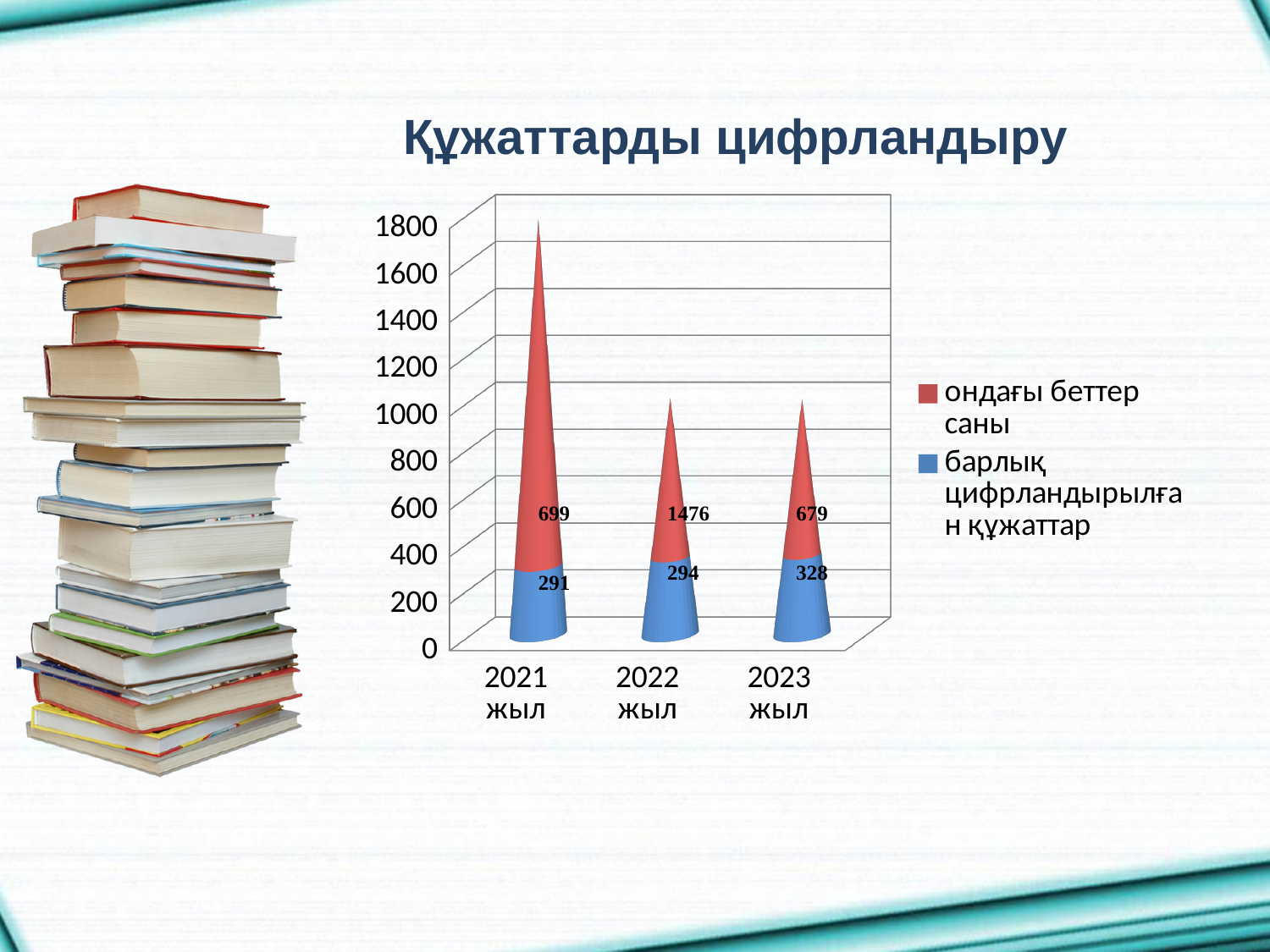
How many years are shown on the x axis of the chart? 3 Which year has the lowest labelled value for 'ондағы беттер саны'? 2023 жыл What is the value of 'ондағы беттер саны' for 2021 жыл? 699 Which is larger: the 'ондағы беттер саны' value for 2021 жыл or for 2023 жыл? 2021 жыл What is the value of 'барлық цифрландырылған құжаттар' for 2021 жыл? 291 What is the title of the slide containing the chart? Құжаттарды цифрландыру What is the value of 'барлық цифрландырылған құжаттар' for 2023 жыл? 328 How many series does the legend list? 2 What is the value of 'ондағы беттер саны' for 2023 жыл? 679 What is the difference between the 'барлық цифрландырылған құжаттар' values for 2023 жыл and 2021 жыл? 37 Which year has the highest labelled value for 'барлық цифрландырылған құжаттар'? 2023 жыл What is the value of 'ондағы беттер саны' for 2022 жыл? 1476